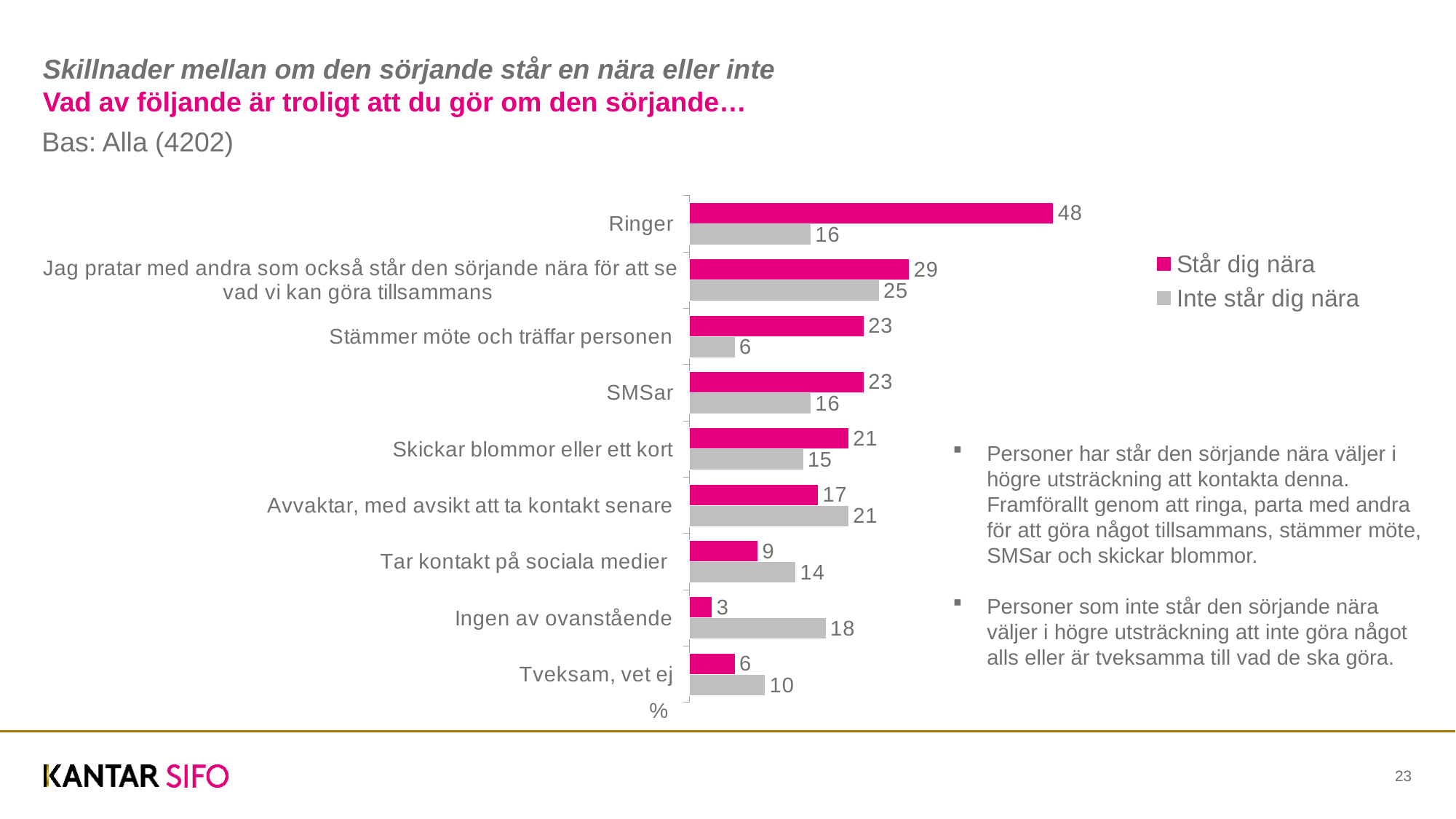
What is the value for "Ingen av ovanstående" in the "Inte står dig nära" series? 18 What is the difference between the "Står dig nära" and "Inte står dig nära" values for "Ringer"? 32 Which category has the lowest value in the "Står dig nära" series? Ingen av ovanstående How many series does the legend list? 2 Which category has the lowest value in the "Inte står dig nära" series? Stämmer möte och träffar personen What type of chart is shown on the slide? Bar chart How many categories are shown in the chart? 9 For "Avvaktar, med avsikt att ta kontakt senare", which series has the larger value? Inte står dig nära What is the value for "Tar kontakt på sociala medier" in the "Står dig nära" series? 9 Which colour represents the "Står dig nära" series? Pink Which category has the highest value in the "Står dig nära" series? Ringer What is the value for "Ringer" in the "Står dig nära" series? 48